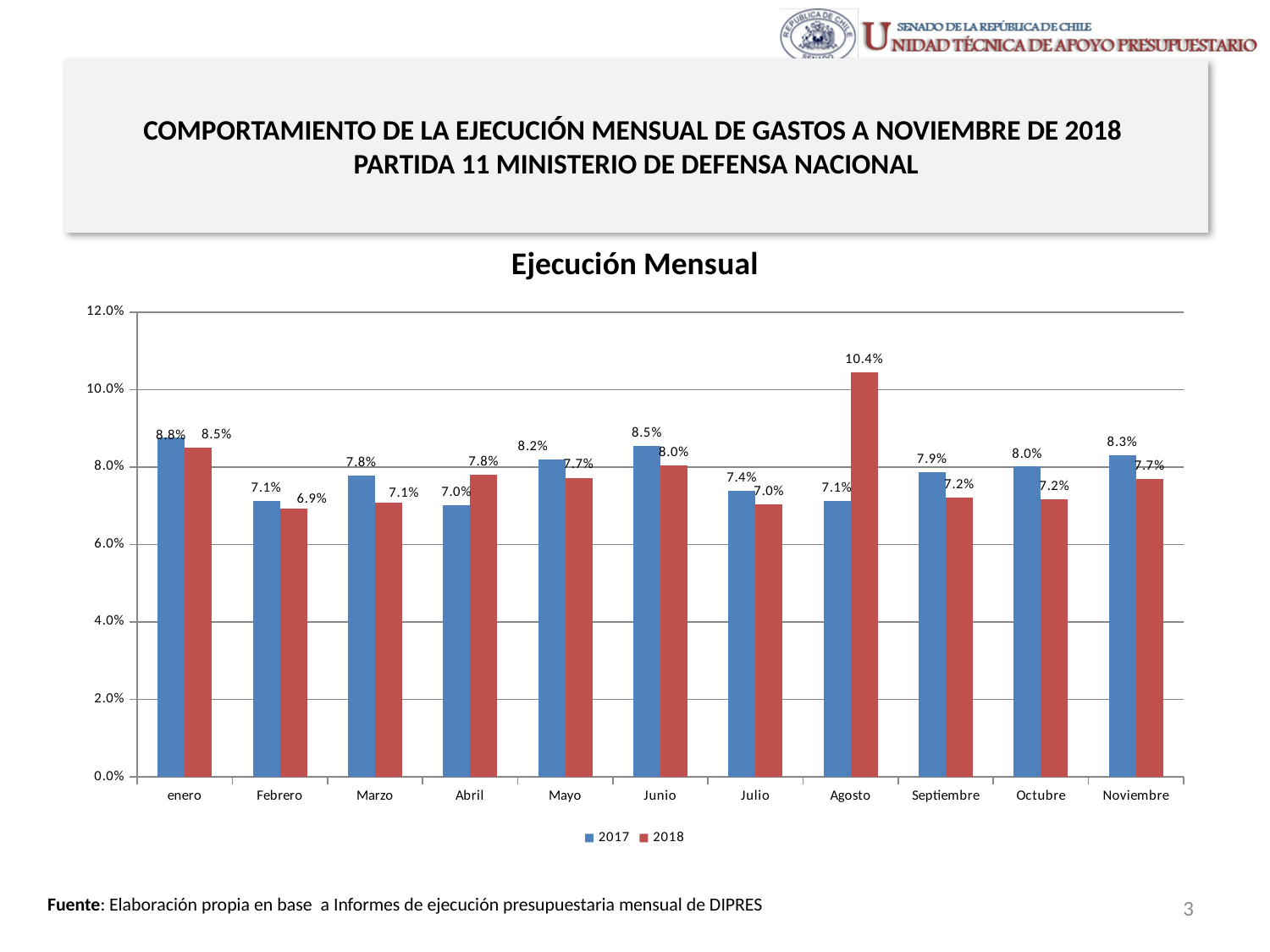
Which month has the highest value for the 2018 series? Agosto Which month has the highest value for the 2017 series? enero How many series does the legend list? 2 What is the title of the chart? Ejecución Mensual How many months are shown on the x axis? 11 What is the value for 2018 in Agosto? 10.4% What is the difference between the 2018 and 2017 values in Agosto? 3.3% What is the value for 2018 in Febrero? 6.9% What is the value for 2017 in Junio? 8.5% What type of chart is shown on the slide? bar chart In Abril, which series has the larger value, 2017 or 2018? 2018 Which month has the lowest value for the 2017 series? Abril